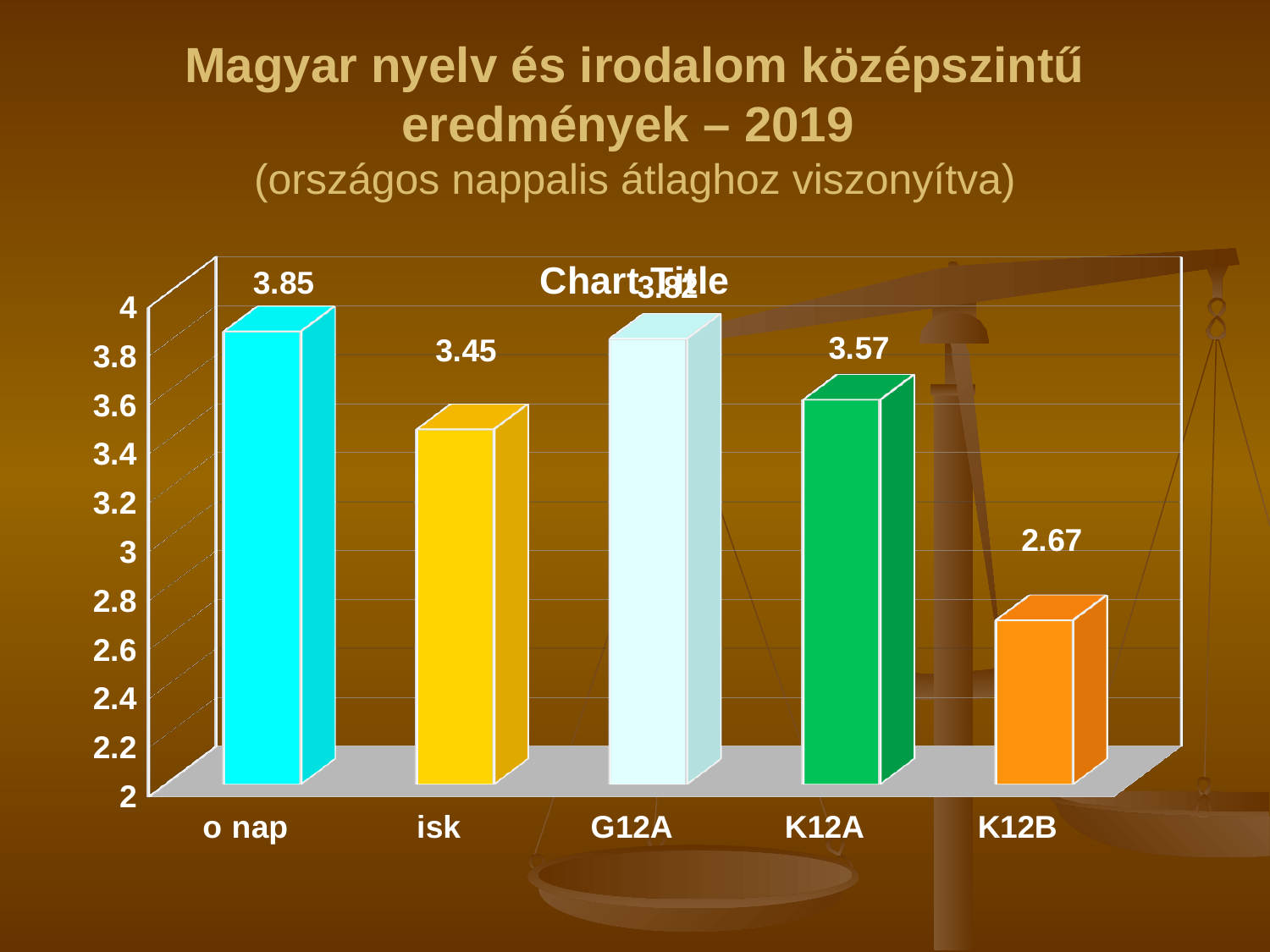
What is the value for K12A? 3.57 What is the value for isk? 3.45 Is the value for K12B greater or less than 3? less Which category has the lowest value? K12B What is the difference between the values for o nap and isk? 0.4 What is the difference between the values for K12A and K12B? 0.9 What is the label of the last category on the x axis? K12B What is the value for o nap? 3.85 What is the value for K12B? 2.67 What kind of chart is shown on the slide? bar chart Which is larger, the value for isk or the value for K12A? K12A How many categories are shown on the x axis? 5